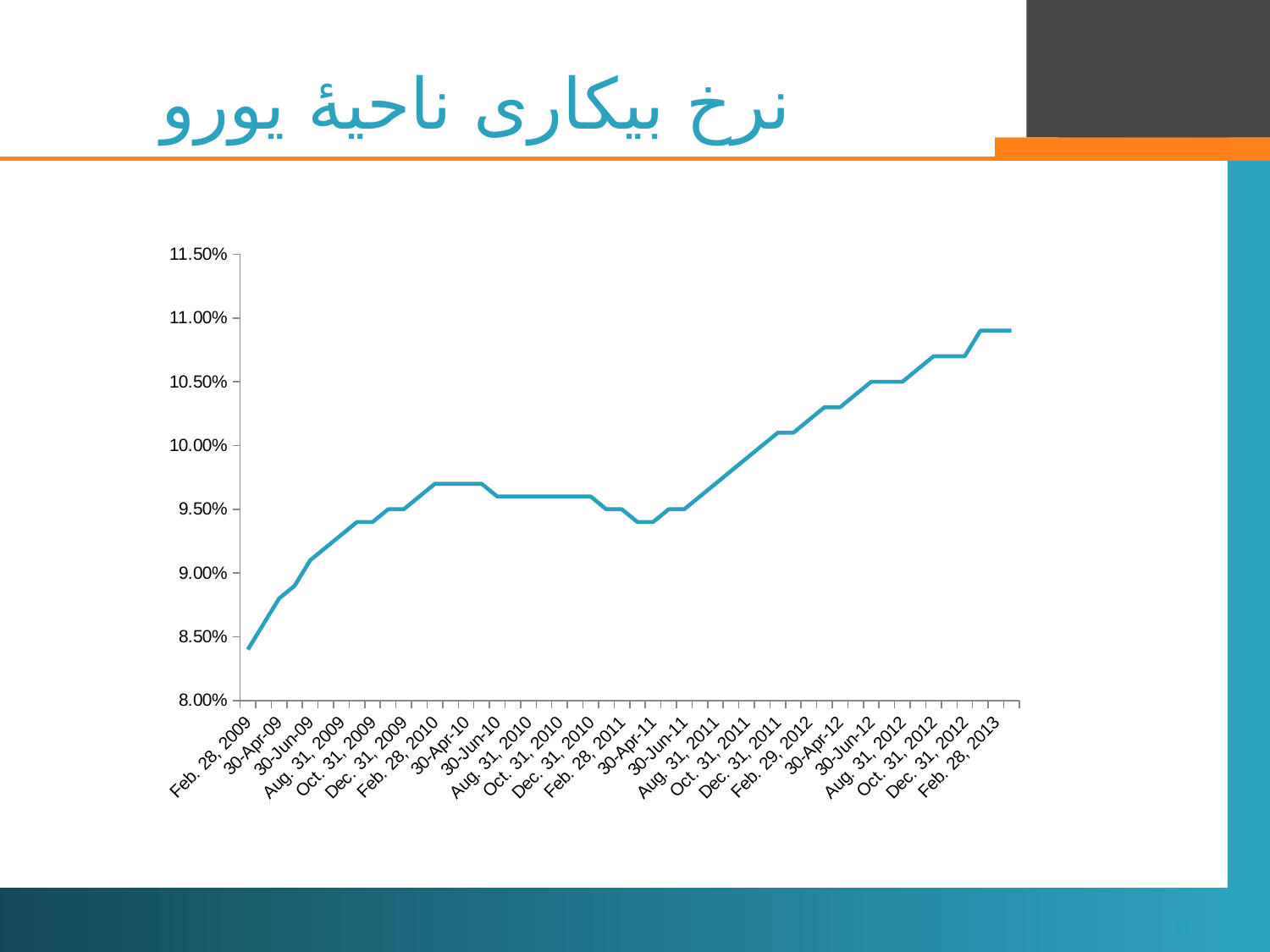
Which is larger, the value for Feb. 28, 2013 or the value for Feb. 28, 2009? Feb. 28, 2013 Which is larger, the value for Feb. 28, 2010 or the value for 30-Apr-11? Feb. 28, 2010 Is the value for Feb. 28, 2009 greater or less than 8.50%? less Overall, do the values rise or fall from Feb. 28, 2009 to Feb. 28, 2013? rise Is the value for Feb. 28, 2010 greater or less than 9.50%? greater What kind of chart is shown on the slide? line chart Is the value for Dec. 31, 2012 greater or less than 10.50%? greater Which date has the lowest value on the chart? Feb. 28, 2009 What is the highest value shown on the vertical axis? 11.50%